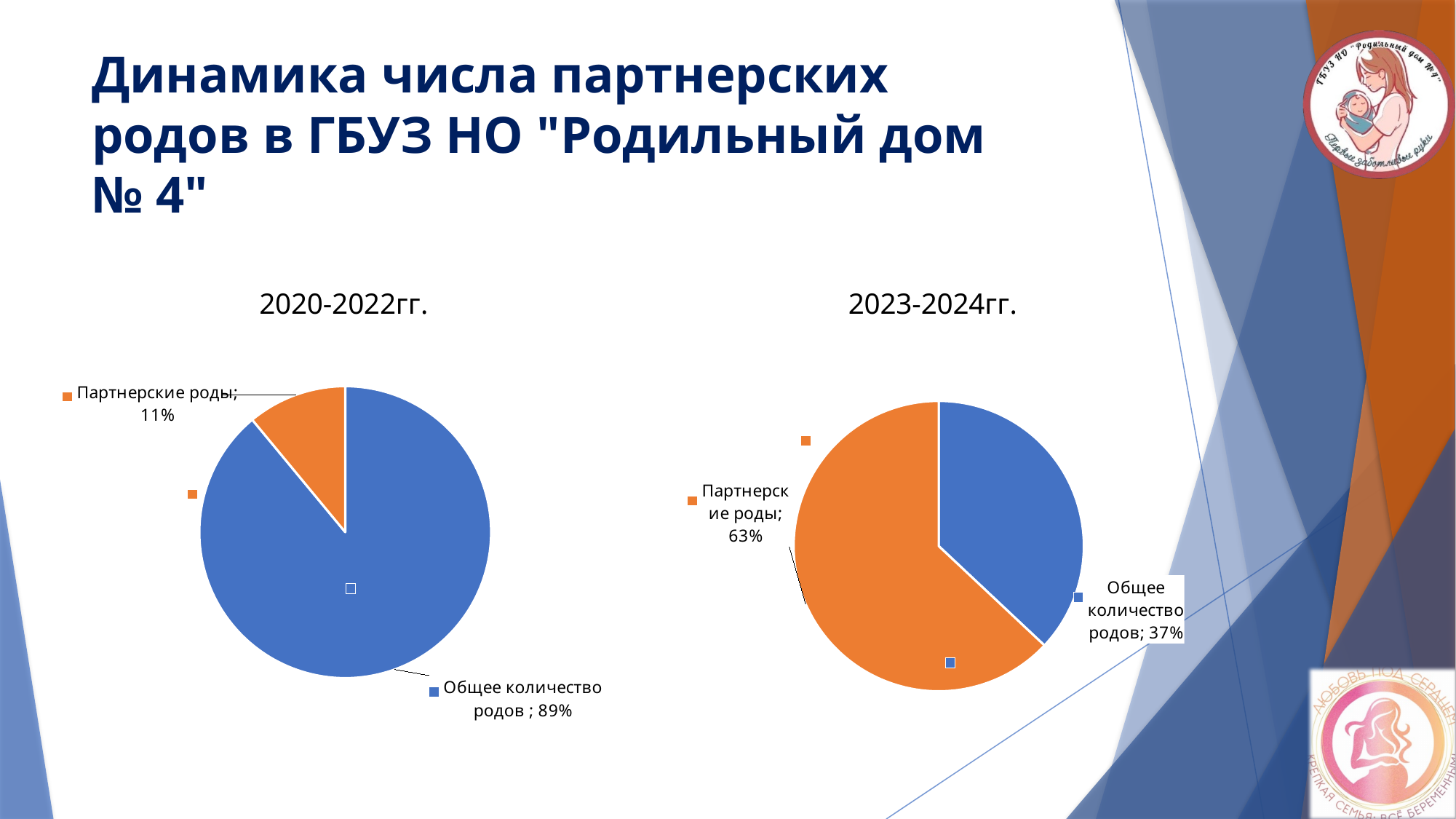
In the "2020-2022гг." chart, what colour is the "Партнерские роды" slice? orange In the "2020-2022гг." chart, what share is shown for "Партнерские роды"? 11% In the "2023-2024гг." chart, what share is shown for "Партнерские роды"? 63% In the "2023-2024гг." chart, what share is shown for "Общее количество родов"? 37% In the "2020-2022гг." chart, which slice is the largest? Общее количество родов In the "2023-2024гг." chart, which is larger: "Партнерские роды" or "Общее количество родов"? Партнерские роды In the "2023-2024гг." chart, which slice is the smallest? Общее количество родов In the "2020-2022гг." chart, what is the difference between the "Общее количество родов" share and the "Партнерские роды" share? 78% How many slices does the "2023-2024гг." pie chart have? 2 In the "2023-2024гг." chart, what is the difference between the "Партнерские роды" share and the "Общее количество родов" share? 26% What kind of chart is the "2020-2022гг." chart? pie chart